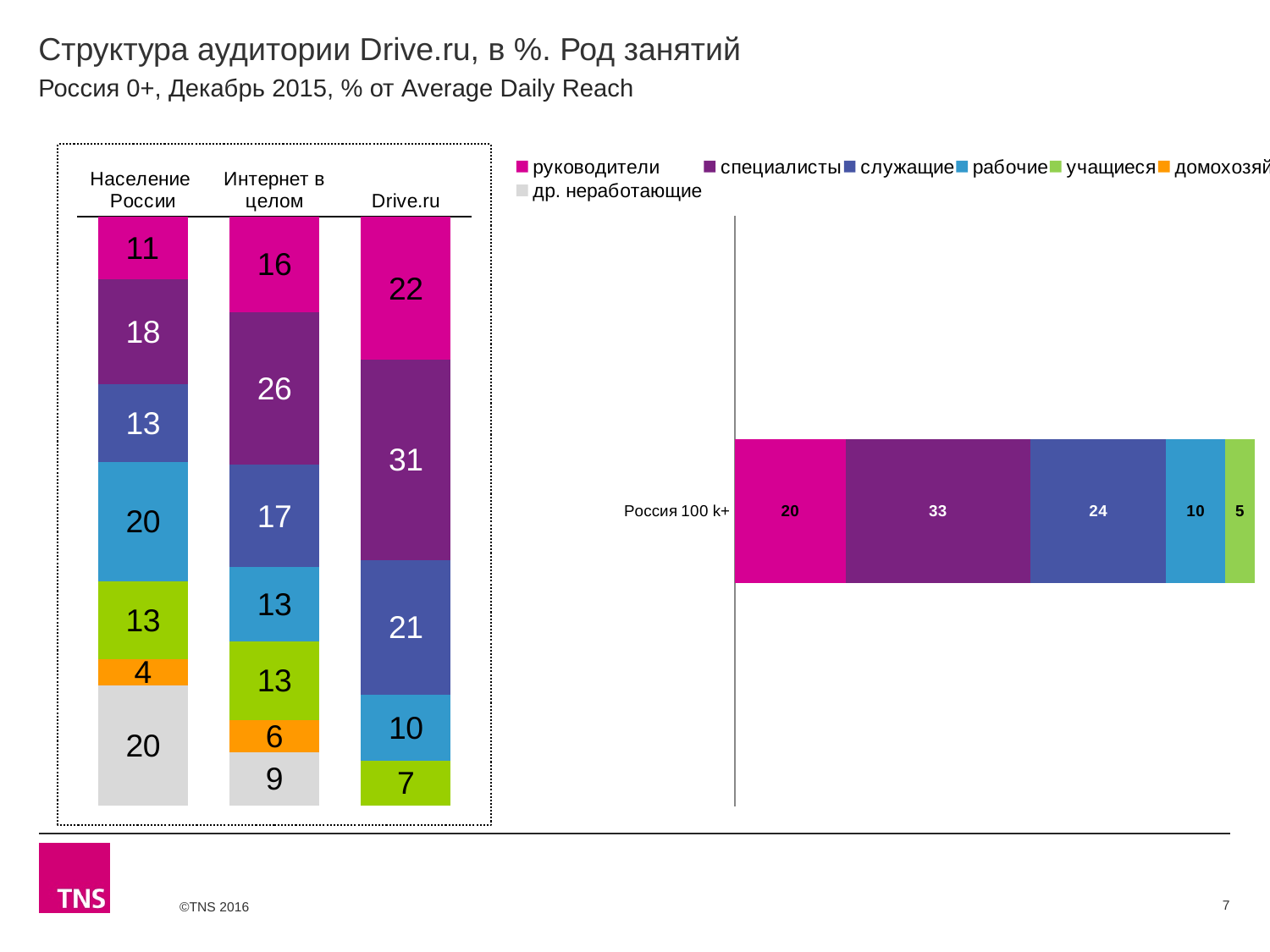
In the left chart, what is the value of the др. неработающие segment for Население России? 20 In the left chart, what is the total of the Drive.ru stacked bar? 91 In the right chart (Россия 100 k+), what is the value of the специалисты segment? 33 How many stacked bars (categories) are shown in the left chart? 3 How many series does the legend list? 7 What type of chart is the right chart (Россия 100 k+)? Stacked bar chart In the right chart (Россия 100 k+), which segment has the largest value? специалисты In the left chart, what is the difference between the руководители value for Drive.ru and for Население России? 11 In the right chart, what is the total of the Россия 100 k+ stacked bar? 92 In the left chart, what is the value of the специалисты segment for Drive.ru? 31 In the right chart (Россия 100 k+), which segment has the smallest value? учащиеся In the left chart, which has a larger специалисты value: Интернет в целом or Drive.ru? Drive.ru